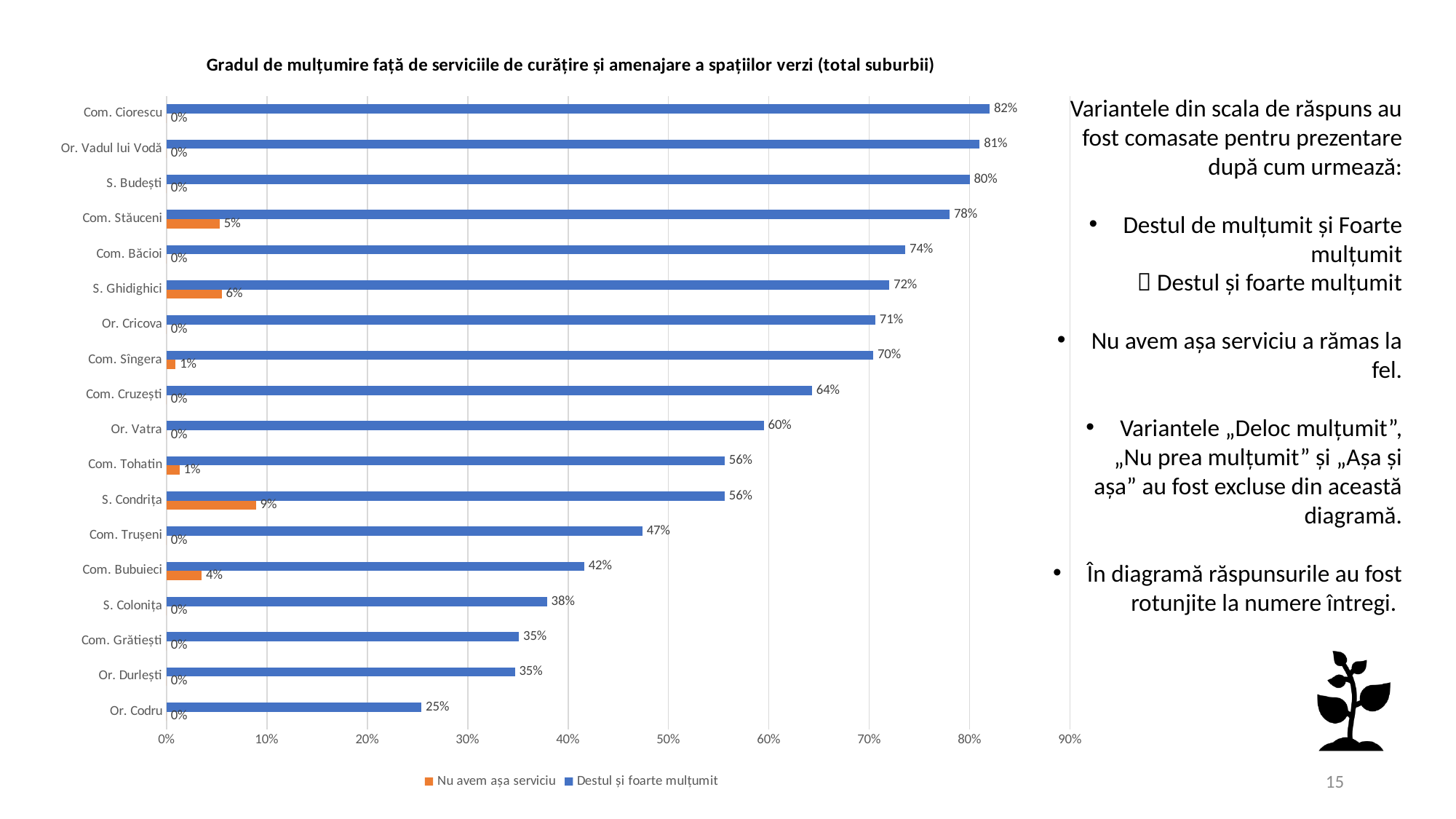
How many categories (localities) are shown on the chart? 18 What is the value of "Destul și foarte mulțumit" for Com. Ciorescu? 82% What kind of chart is shown on the slide? Bar chart Which category has the lowest value for "Destul și foarte mulțumit"? Or. Codru How many series does the legend list? 2 What is the value of "Nu avem așa serviciu" for Com. Stăuceni? 5% Which has a larger "Destul și foarte mulțumit" value, Com. Băcioi or Com. Trușeni? Com. Băcioi What is the value of "Destul și foarte mulțumit" for Or. Codru? 25% Which category has the highest value for "Nu avem așa serviciu"? S. Condrița Which category has the highest value for "Destul și foarte mulțumit"? Com. Ciorescu What is the difference between the "Destul și foarte mulțumit" values for Com. Ciorescu and Or. Codru? 57% What is the value of "Nu avem așa serviciu" for S. Condrița? 9%